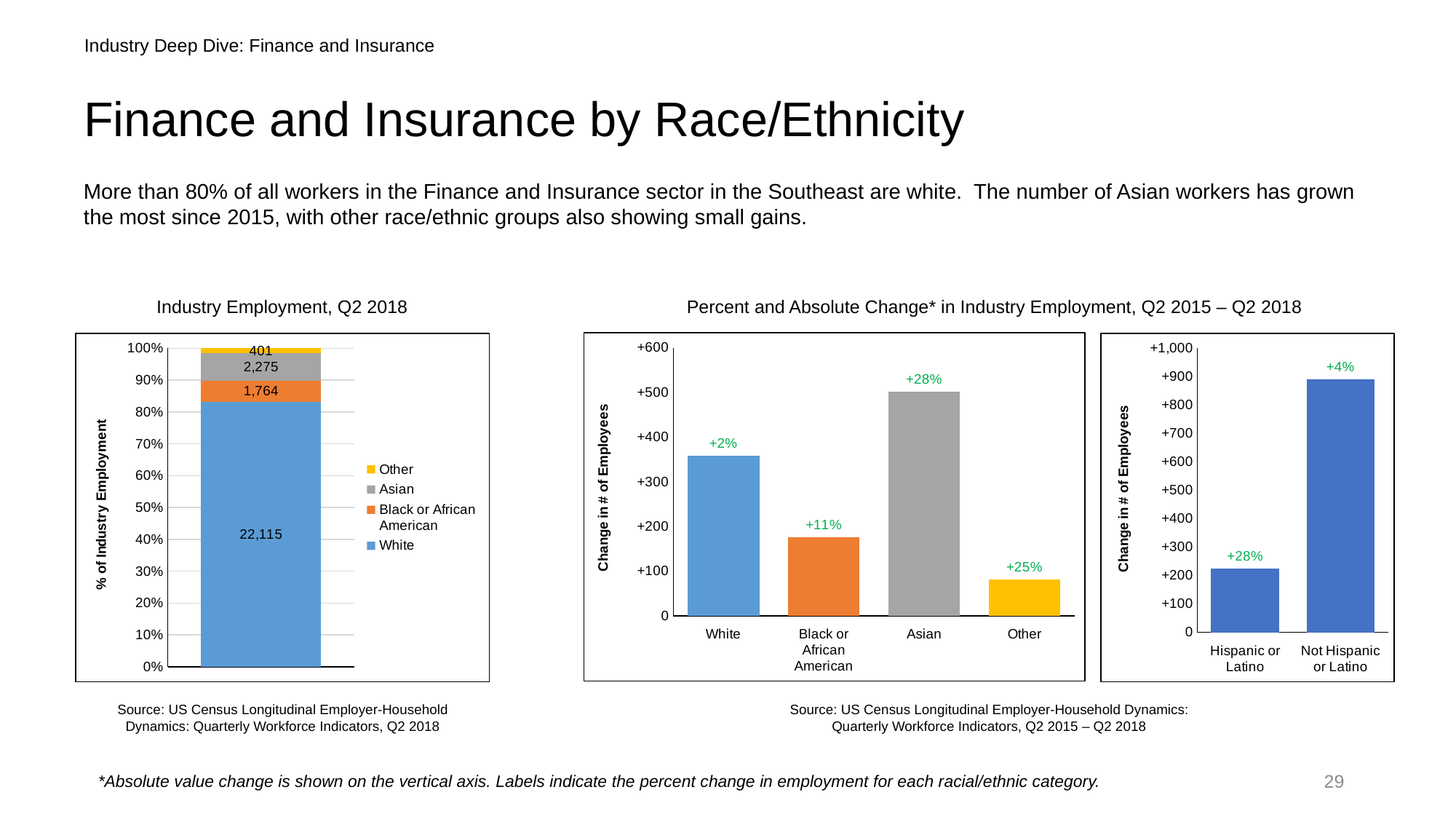
In the Industry Employment, Q2 2018 chart, how many White employees are shown? 22,115 In the middle chart showing change in industry employment by race, what percent change label is shown for Asian? +28% In the right-hand chart, what percent change label is shown for Hispanic or Latino? +28% In the middle chart showing change in industry employment by race, what percent change label is shown for White? +2% In the middle chart showing change in industry employment by race, is the change in number of employees for White greater or less than +300? greater In the Industry Employment, Q2 2018 chart, how many series does the legend list? 4 In the right-hand chart, is the change in number of employees for Not Hispanic or Latino greater or less than +800? greater In the Industry Employment, Q2 2018 chart, what is the difference between the Asian and Black or African American values? 511 In the Industry Employment, Q2 2018 chart, what is the value for Black or African American employees? 1,764 In the Industry Employment, Q2 2018 chart, what is the value for Asian employees? 2,275 In the middle chart showing change in industry employment by race, which category has the largest change in number of employees? Asian In the Industry Employment, Q2 2018 chart, which group has the smallest number of employees? Other